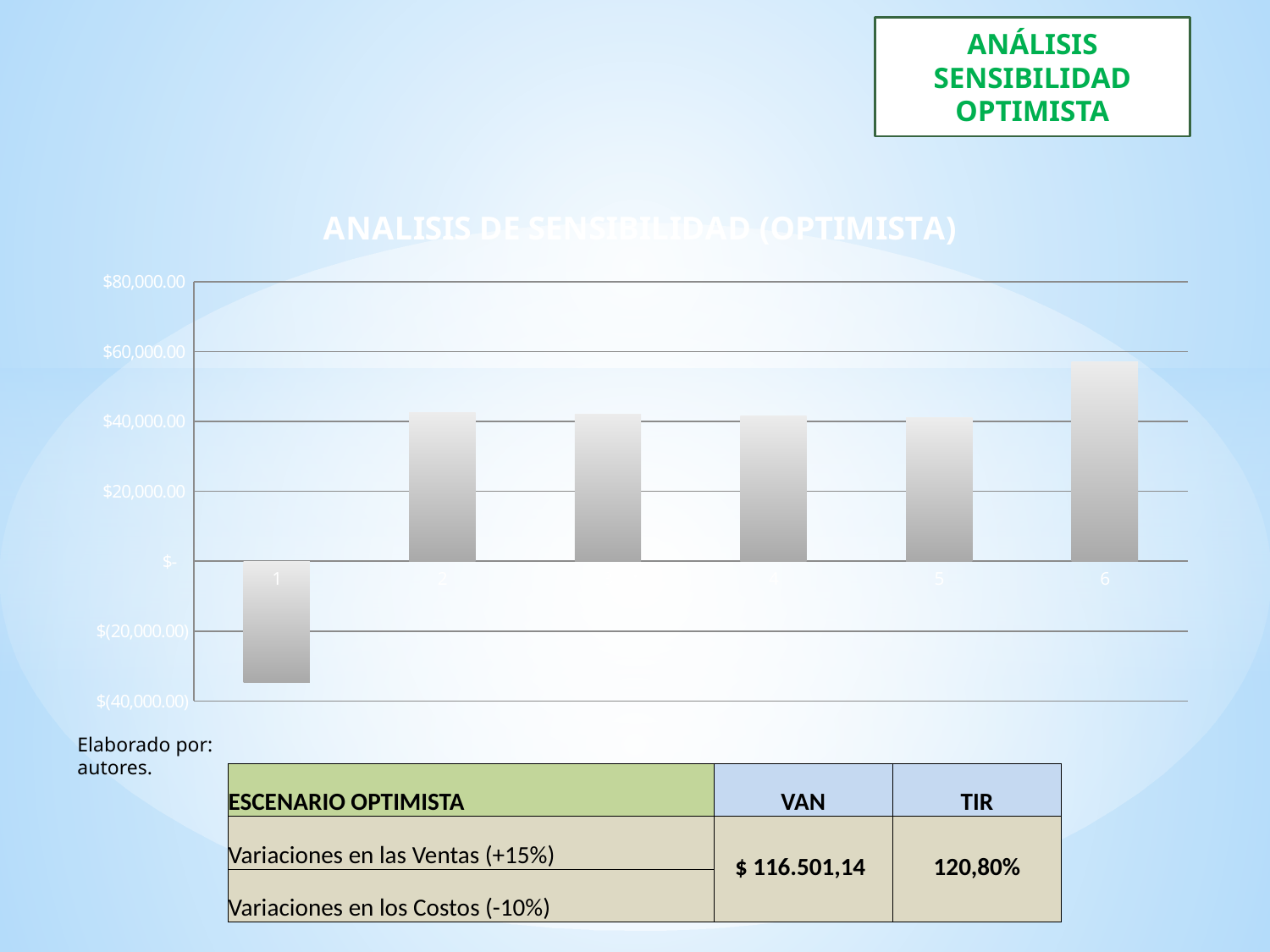
Which is larger, the value for category 1 or the value for category 4? 4 How many bars in the chart have a negative value? 1 Is the value for category 1 greater or less than $(20,000.00)? less What is the title of the chart? ANALISIS DE SENSIBILIDAD (OPTIMISTA) Which category has the highest value in the chart? 6 Is the value for category 6 greater or less than $40,000.00? greater What kind of chart is shown on the slide? bar chart How many bars are plotted in the chart? 6 Which is larger, the value for category 6 or the value for category 2? 6 Which category has the lowest value in the chart? 1 Is the value for category 6 greater or less than $60,000.00? less